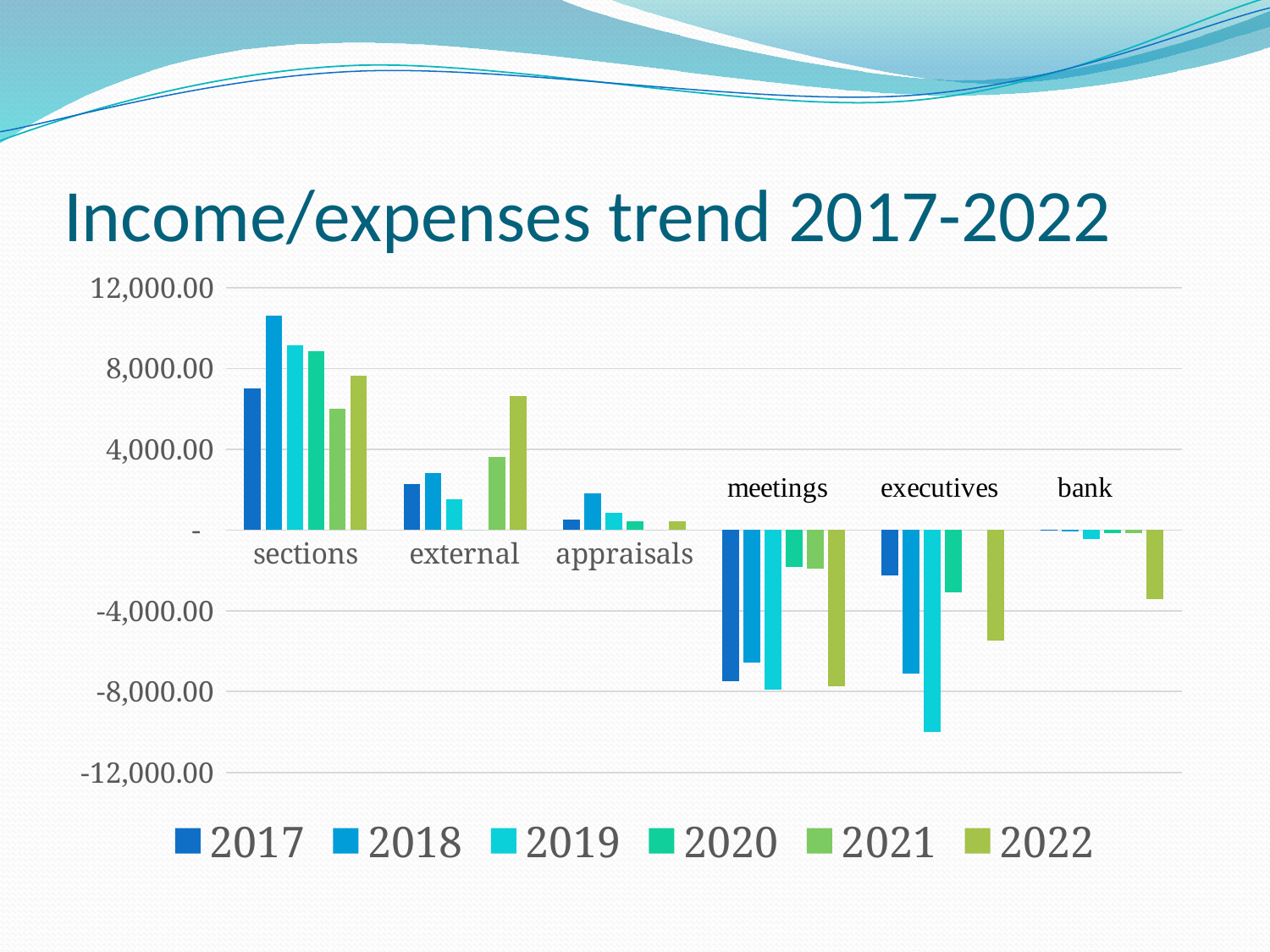
What kind of chart is shown on the slide? bar chart Which is larger, the value for sections in 2017 or in 2021? 2017 Which is larger, the value for external in 2021 or in 2022? 2022 Is the value for sections in 2021 greater or less than 8,000.00? less How many series does the legend list? 6 In the executives category, which year has the lowest (most negative) value? 2019 Is the value for sections in 2018 greater or less than 8,000.00? greater In the sections category, which year has the highest value? 2018 How many categories are shown on the x axis? 6 Is the value for executives in 2019 greater or less than -8,000.00? less What is the title of the chart? Income/expenses trend 2017-2022